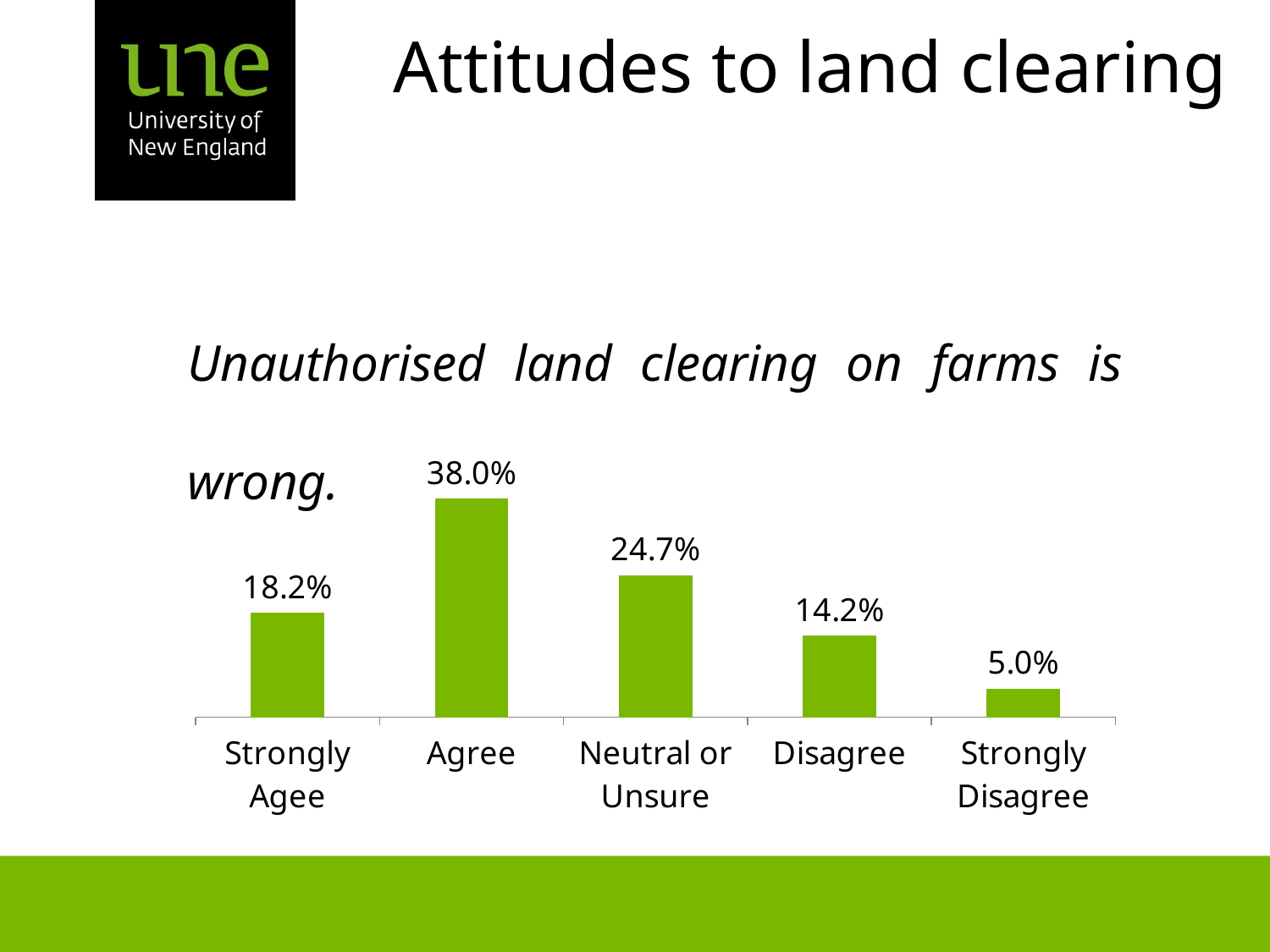
Which category has the highest value? Agree What is the value for Neutral or Unsure? 24.7% What kind of chart is shown on the slide? Bar chart What is the difference between the Strongly Agee and Strongly Disagree values? 13.2% Which is larger, the value for Strongly Agee or the value for Disagree? Strongly Agee What percentage of respondents chose Agree? 38.0% What is the value for Disagree? 14.2% What is the difference between the Agree and Disagree values? 23.8% Which category has the lowest value? Strongly Disagree How many categories are shown on the x axis? 5 What is the value for Strongly Disagree? 5.0% What statement were respondents asked to rate in this chart? Unauthorised land clearing on farms is wrong.